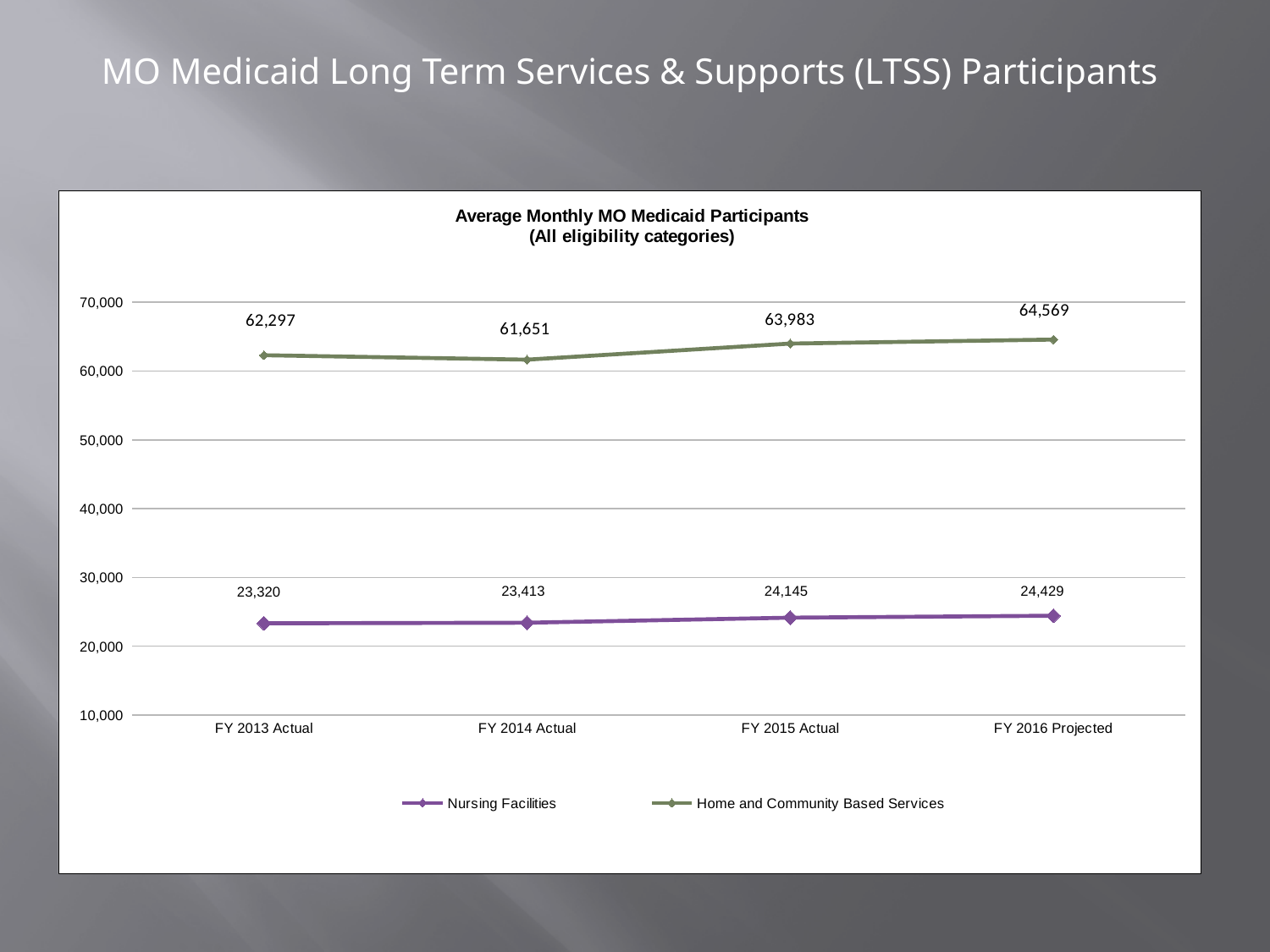
What is the value for Nursing Facilities in FY 2013 Actual? 23,320 Does the Nursing Facilities series rise or fall from FY 2013 Actual to FY 2016 Projected? Rise In which fiscal year is the Home and Community Based Services value lowest? FY 2014 Actual Which series has the larger value in FY 2014 Actual, Nursing Facilities or Home and Community Based Services? Home and Community Based Services What is the difference between Home and Community Based Services and Nursing Facilities in FY 2015 Actual? 39,838 What is the value for Home and Community Based Services in FY 2016 Projected? 64,569 How many fiscal years are shown on the x axis? 4 By how much does the Nursing Facilities value increase from FY 2013 Actual to FY 2016 Projected? 1,109 How many series does the legend list? 2 What is the value for Home and Community Based Services in FY 2014 Actual? 61,651 What kind of chart is shown on the slide? Line chart In which fiscal year is the Nursing Facilities value highest? FY 2016 Projected